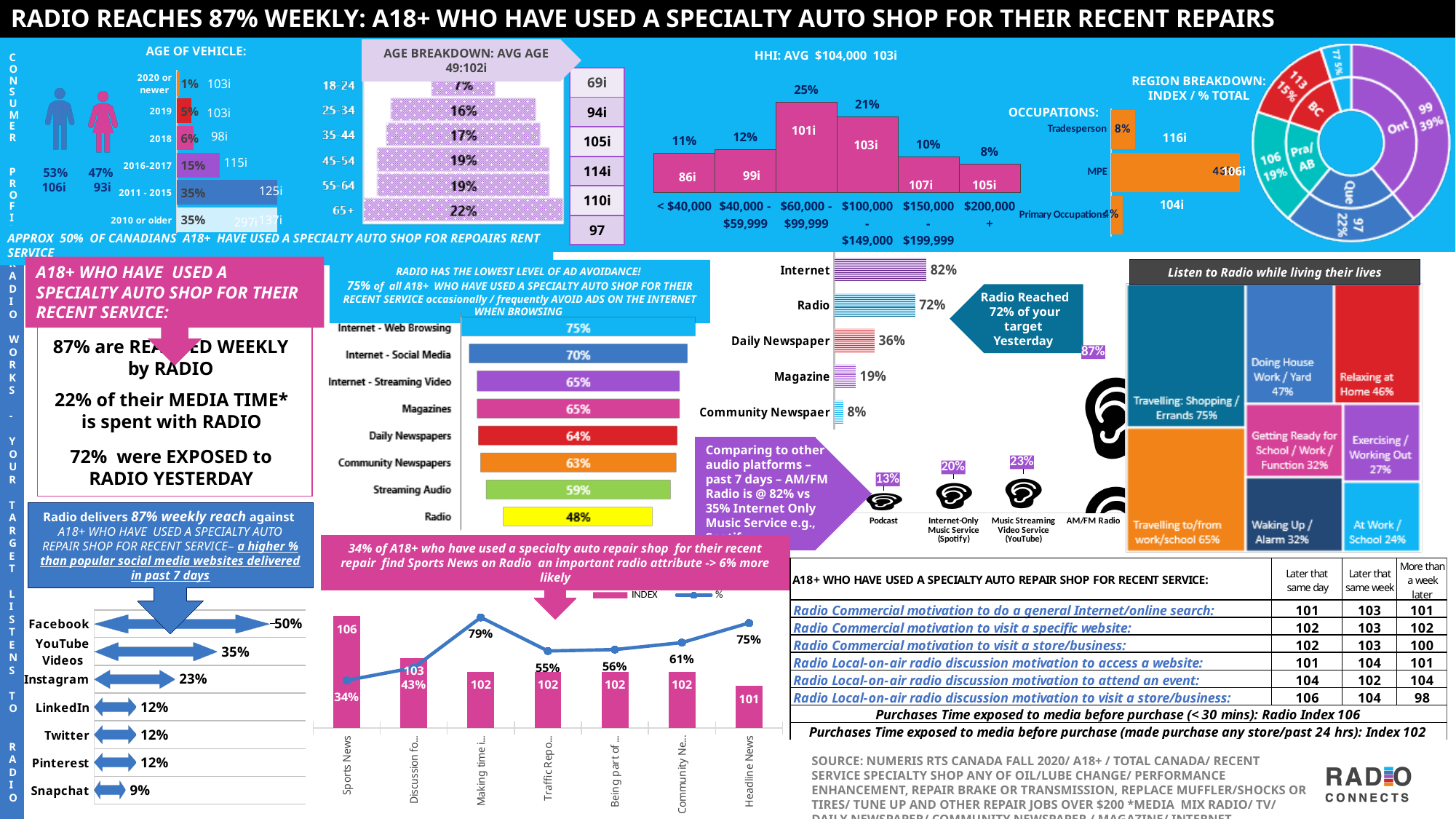
In the Age of Vehicle bar chart, what is the index shown for 2011 - 2015? 125i In the social media bar chart, which is larger, YouTube Videos or Instagram? YouTube Videos In the media exposed yesterday bar chart (Internet, Radio, Daily Newspaper, Magazine, Community Newspaper), what is the value for Daily Newspaper? 36% In the radio attributes combo chart at the bottom centre, how many series does the legend list? 2 In the Age Breakdown chart, what percentage is shown for the 65+ age group? 22% In the ad avoidance bar chart, what is the difference between Internet - Social Media and Streaming Audio? 11% In the HHI bar chart, which income group has the lowest percentage? $200,000 + In the social media bar chart (Facebook through Snapchat), how many platforms are listed? 7 In the radio attributes combo chart at the bottom centre, what index value is shown for Sports News? 106 In the ad avoidance bar chart (Internet - Web Browsing through Radio), which category has the highest value? Internet - Web Browsing In the HHI bar chart, what percentage is shown for the $60,000 - $99,999 income group? 25% In the ad avoidance bar chart (Internet - Web Browsing through Radio), what is the value for Radio? 48%